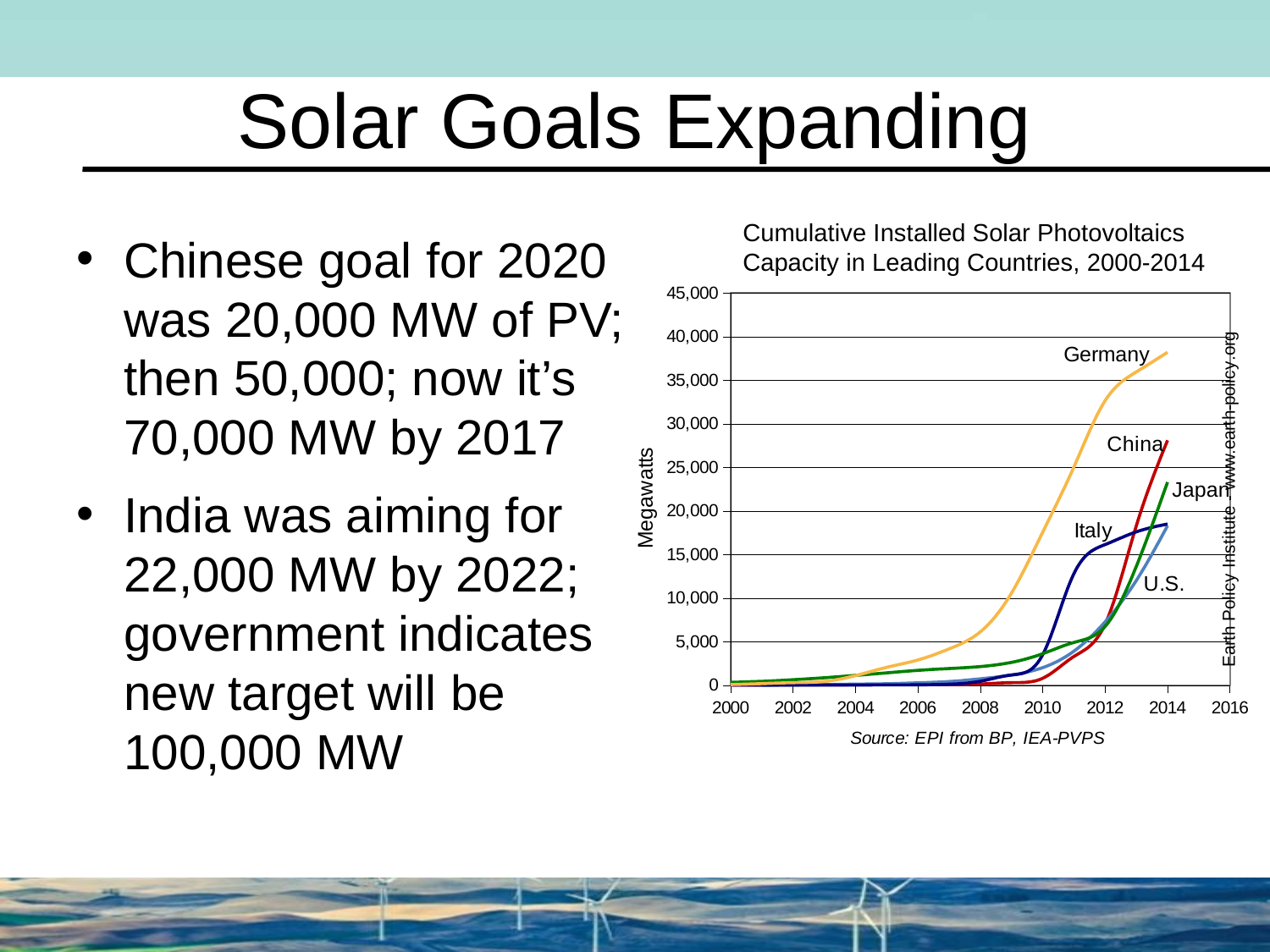
Which is larger in 2014, the capacity of Germany or the capacity of China? Germany Is the value for Italy in 2014 greater or less than 20,000 megawatts? less Which country has the highest cumulative installed solar PV capacity in 2014? Germany Is the value for Japan in 2014 greater or less than 20,000 megawatts? greater Is the value for China in 2014 greater or less than 25,000 megawatts? greater What unit is shown on the vertical axis of the chart? Megawatts How many countries are plotted as lines on the chart? 5 What is the title of the chart? Cumulative Installed Solar Photovoltaics Capacity in Leading Countries, 2000-2014 Which is larger in 2012, the capacity of Italy or the capacity of China? Italy What kind of chart is shown on the slide? line chart Does Germany's cumulative installed capacity rise or fall from 2000 to 2014? rise